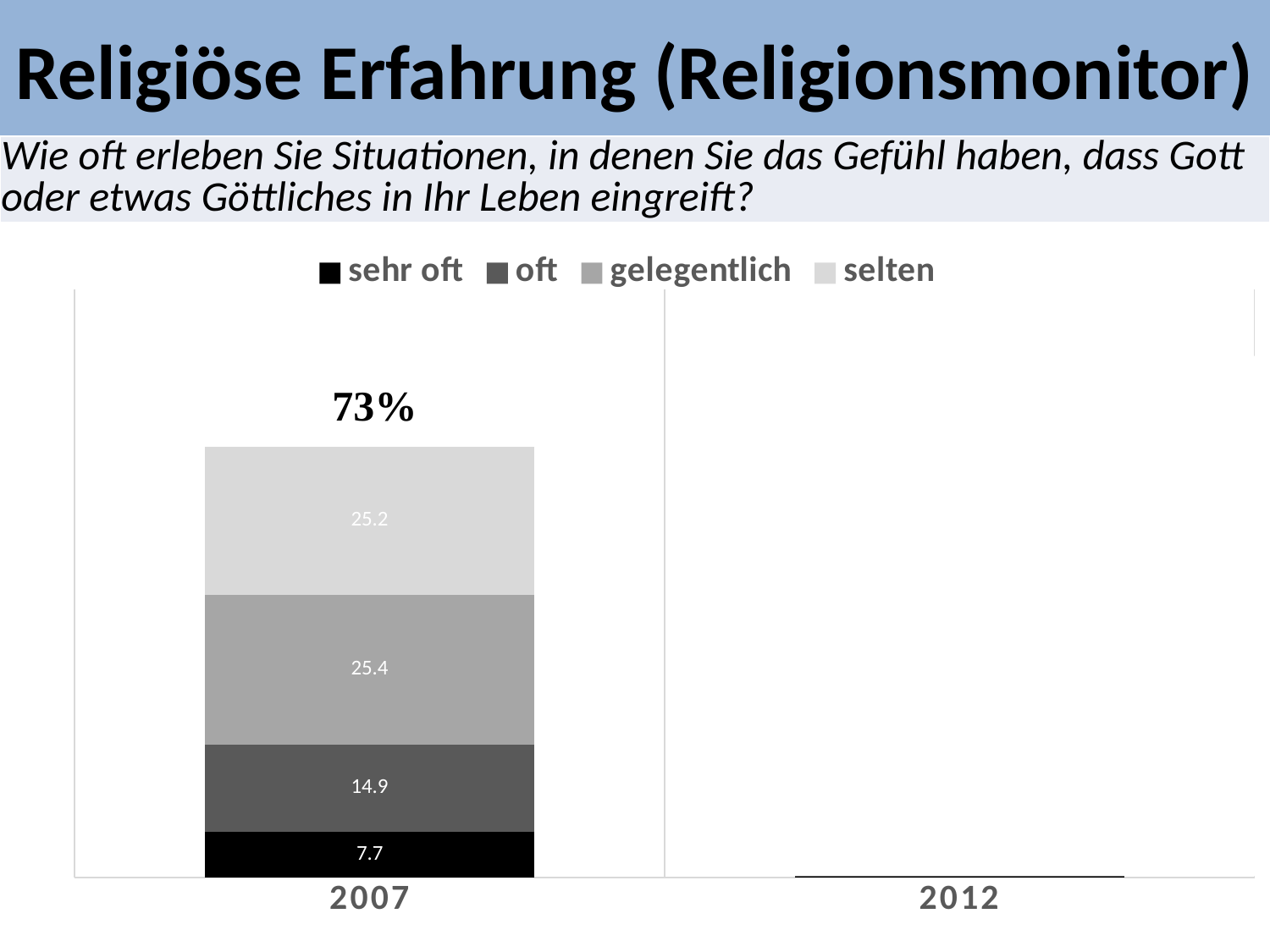
How many series does the legend list? 4 How many categories are shown on the x axis? 2 What is the value for 'gelegentlich' in 2007? 25.4 What is the value for 'sehr oft' in 2007? 7.7 Which is larger in 2007, the value for 'oft' or the value for 'sehr oft'? oft What is the value for 'selten' in 2007? 25.2 Which series has the smallest value in the 2007 bar? sehr oft What total is printed above the 2007 bar? 73% What is the difference between the 'gelegentlich' and 'oft' values in 2007? 10.5 Which legend entry is shown in black? sehr oft What is the value for 'oft' in 2007? 14.9 What kind of chart is shown on the slide? stacked bar chart